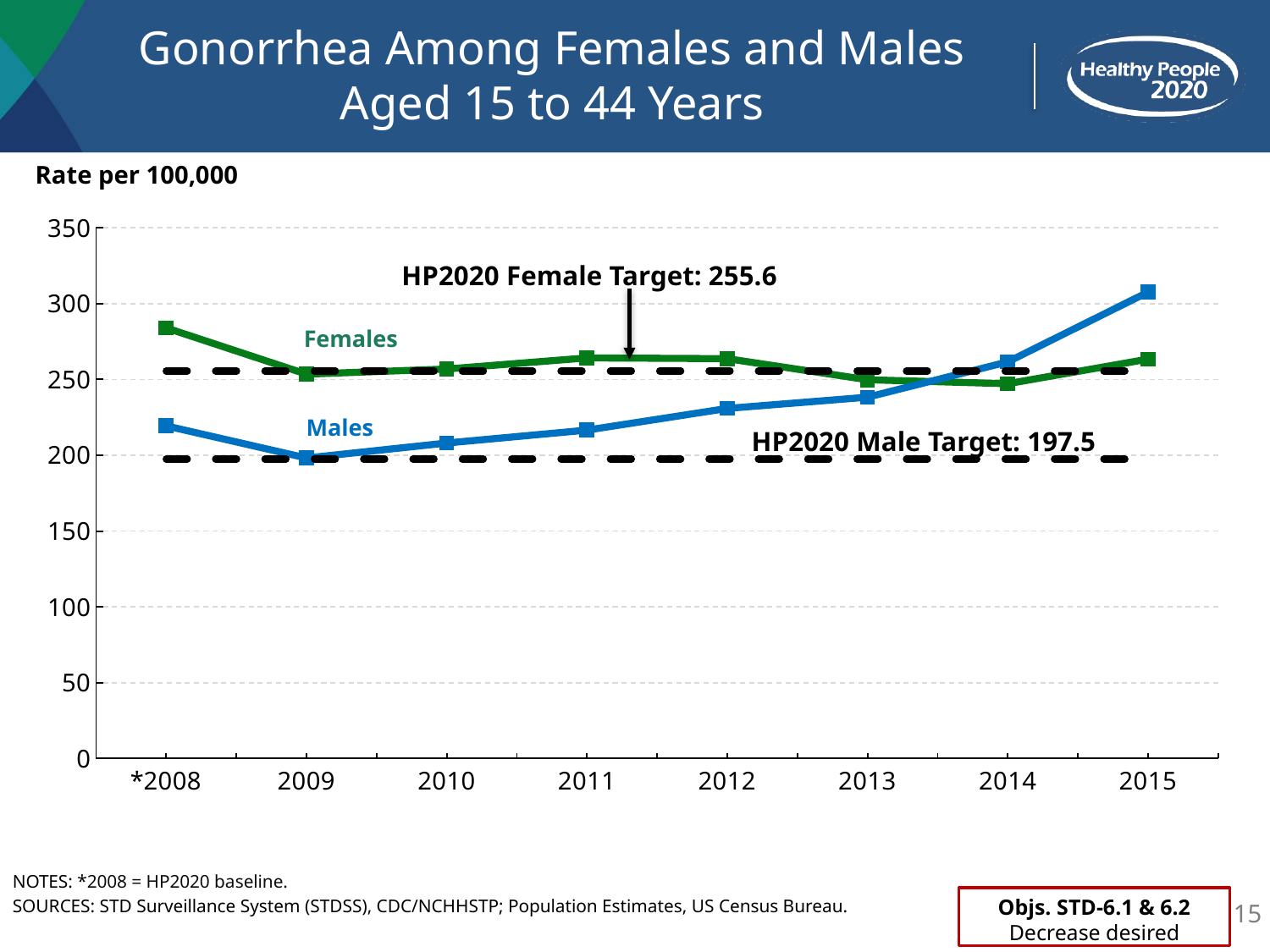
In which year is the Males rate highest? 2015 In 2015, which series has the higher rate, Females or Males? Males Is the Males value for *2008 greater or less than 200? greater What is the HP2020 Male Target shown on the chart? 197.5 What kind of chart is shown on the slide? line chart How many years are shown on the x axis of the chart? 8 What is the HP2020 Female Target shown on the chart? 255.6 In which year is the Males rate lowest? 2009 In which year is the Females rate highest? *2008 Do the Males values rise or fall from 2009 to 2015? rise Is the Males value for 2015 greater or less than 300? greater